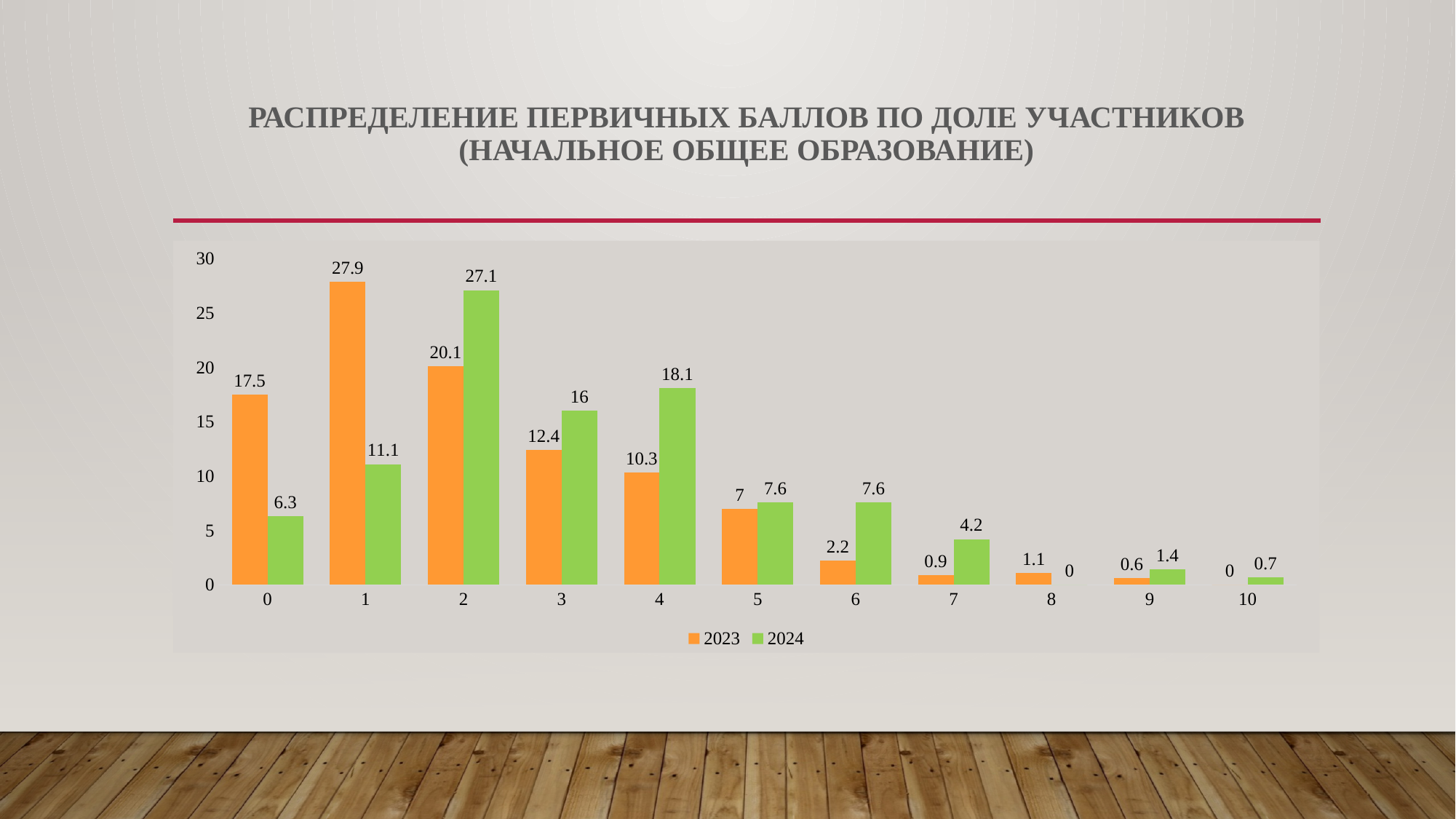
What is the value for category 1 in the 2023 series? 27.9 How many series does the legend list? 2 Which category has the lowest value in the 2024 series? 8 Which category has the highest value in the 2023 series? 1 Which is larger for category 3: the 2023 value or the 2024 value? 2024 What is the value for category 7 in the 2023 series? 0.9 What kind of chart is shown on the slide? bar chart What is the value for category 4 in the 2024 series? 18.1 What is the value for category 2 in the 2024 series? 27.1 Which colour represents the 2024 series? green What is the difference between the 2023 and 2024 values for category 0? 11.2 How many categories are shown on the x axis? 11